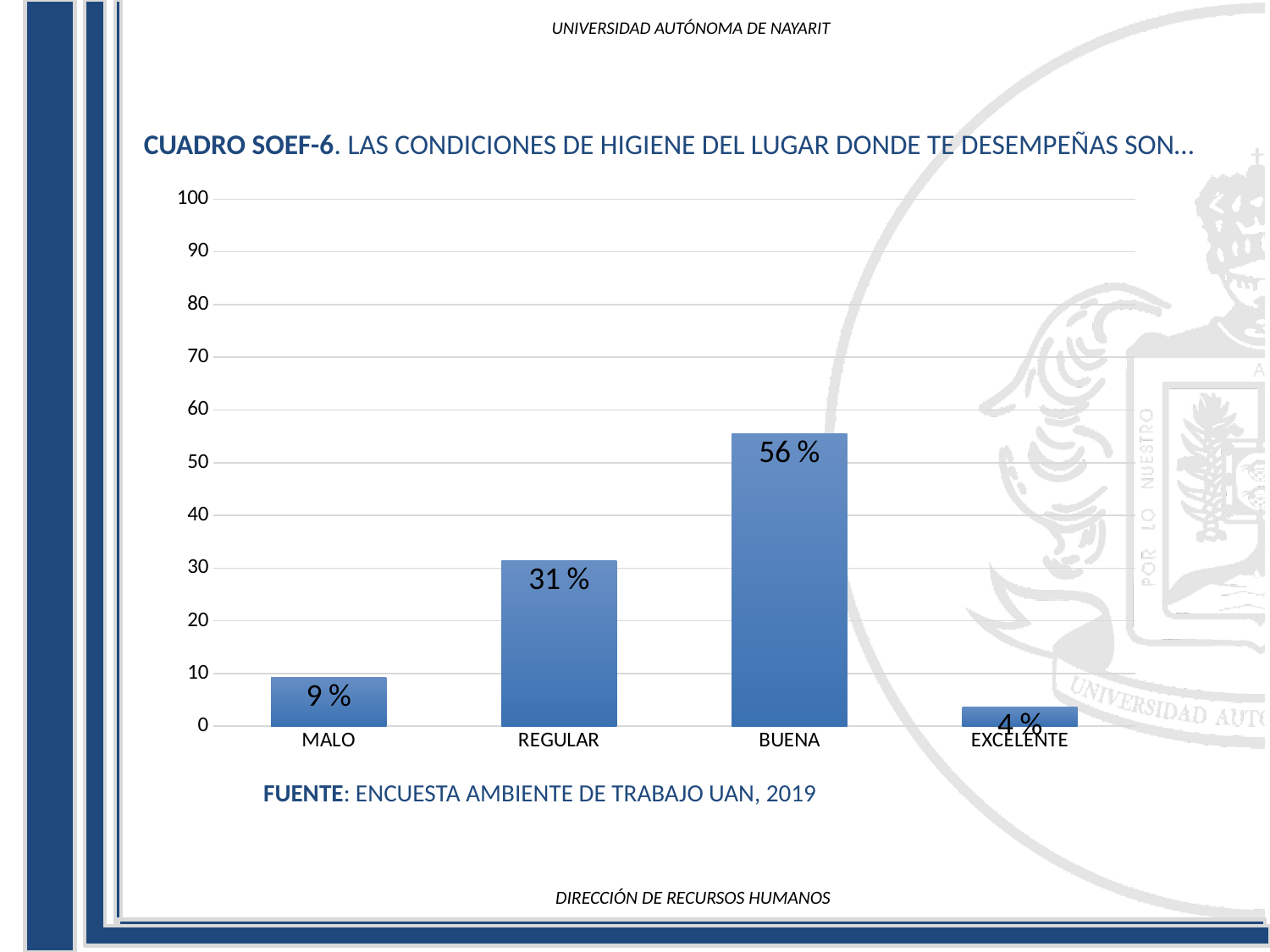
Which category has the lowest value? EXCELENTE What is the value for BUENA? 56 % What is the difference between the values for BUENA and REGULAR? 25 % How many categories are shown on the x axis? 4 What is the value for REGULAR? 31 % What is the value for MALO? 9 % What is the value for EXCELENTE? 4 % What kind of chart is shown on the slide? bar chart Is the value for REGULAR greater or less than 40? less Which category has the highest value? BUENA Which is larger, the value for MALO or the value for EXCELENTE? MALO What source is cited below the chart? ENCUESTA AMBIENTE DE TRABAJO UAN, 2019